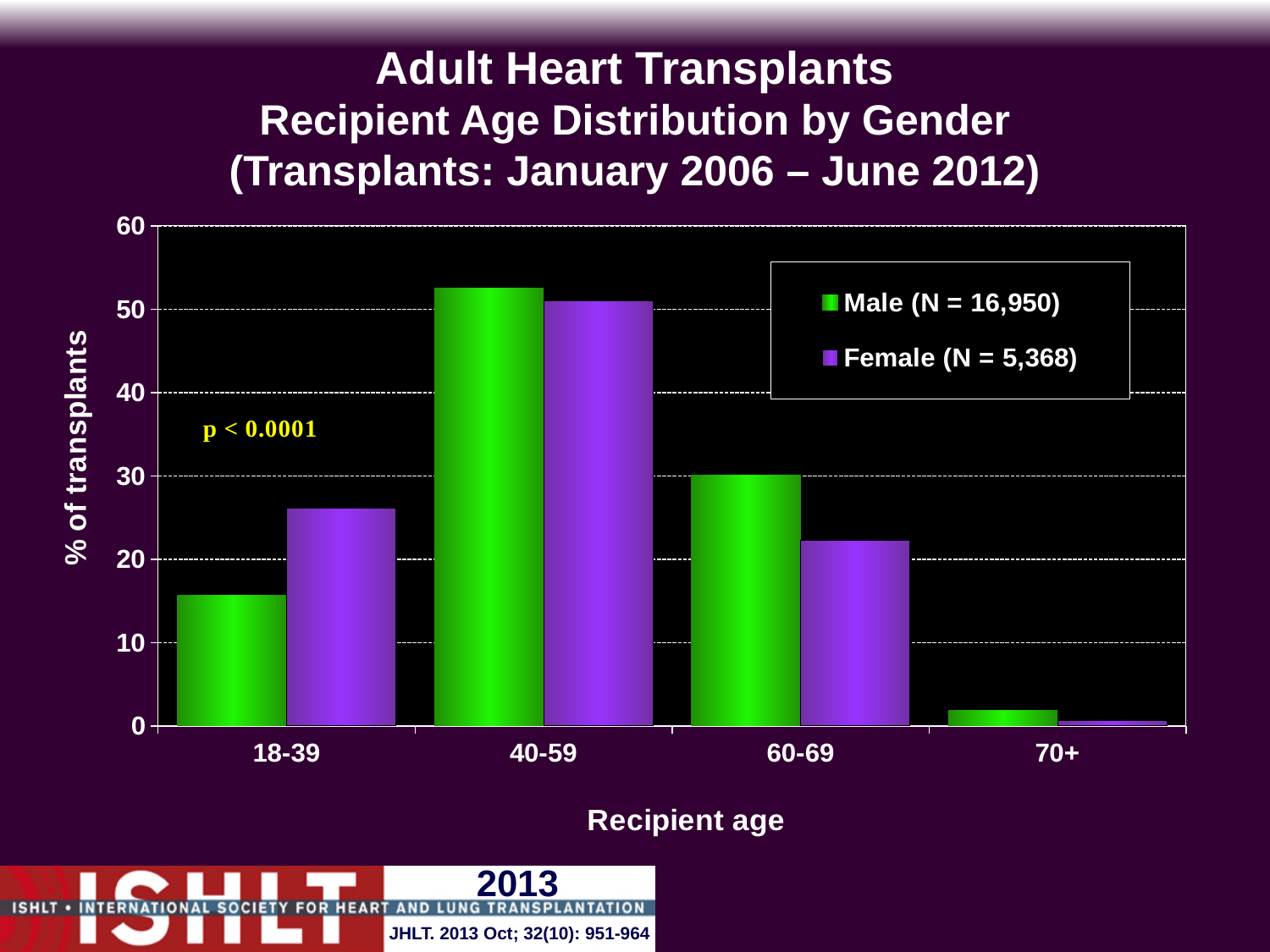
In the 18-39 age group, which series has the larger percentage of transplants, Male or Female? Female Which recipient age group has the lowest percentage of transplants for Female recipients? 70+ Is the value for Male recipients aged 70+ greater or less than 10? less How many recipient age groups are shown on the x axis? 4 Is the value for Female recipients aged 18-39 greater or less than 20? greater Is the value for Male recipients aged 40-59 greater or less than 50? greater How many series does the legend list? 2 What is the N value given in the legend for Female recipients? 5,368 Which recipient age group has the highest percentage of transplants for Male recipients? 40-59 What kind of chart is shown on the slide? bar chart In the 60-69 age group, which series has the larger percentage of transplants, Male or Female? Male